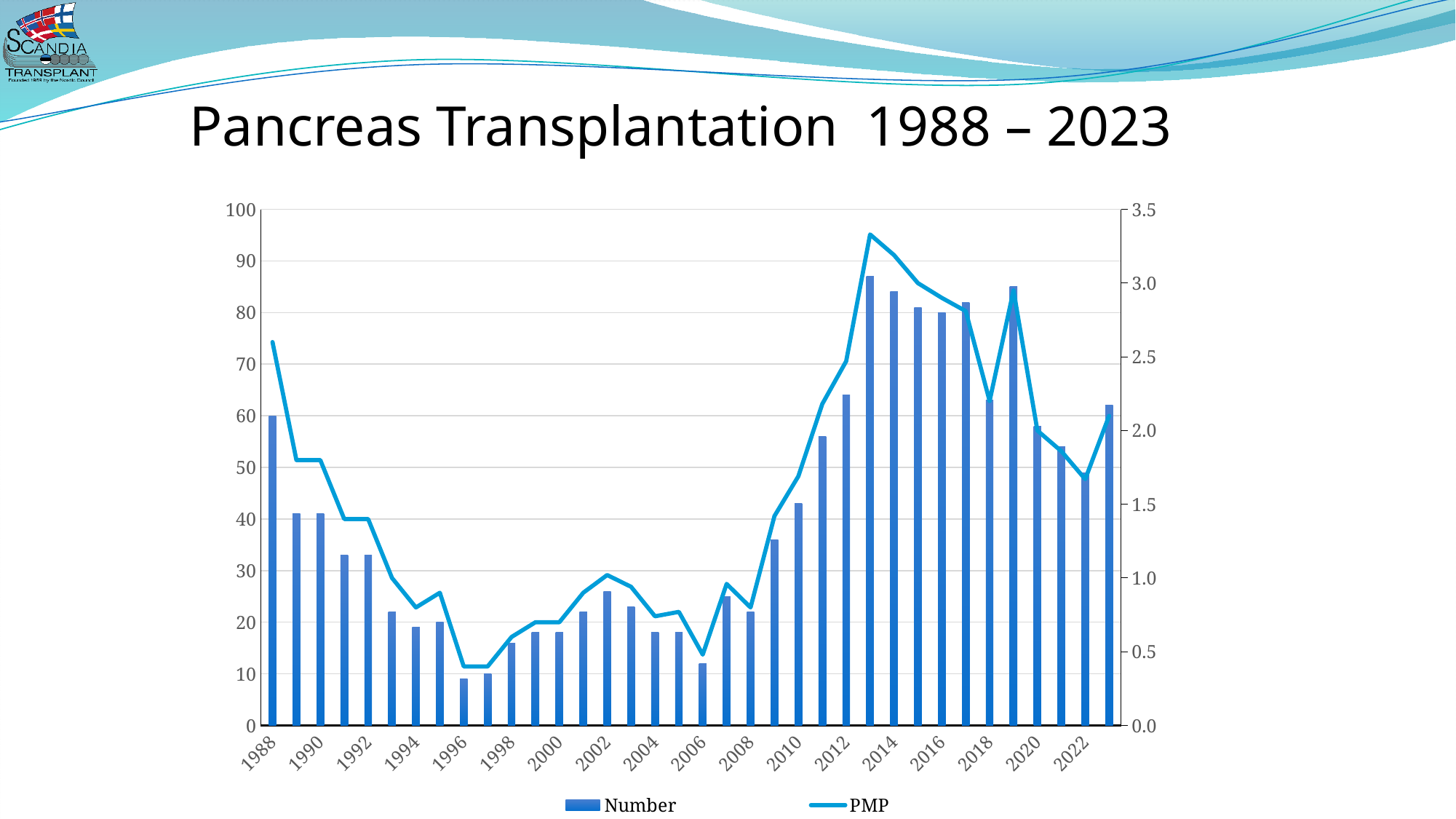
What is the Number value for 1988? 60 Which year has the highest Number of pancreas transplantations? 2013 Do the Number bars rise or fall from 1988 to 1996? fall Which year has the larger Number value, 2013 or 2018? 2013 What are the two series named in the legend? Number and PMP What kind of chart is shown on the slide? A combined bar and line chart Is the Number value for 2006 greater or less than 20? less Is the PMP value for 2013 greater or less than 3.0? greater How many series does the legend list? 2 Which year has the lowest Number of pancreas transplantations? 1996 Is the Number value for 2013 greater or less than 80? greater How many years (bars) are plotted on the chart? 36